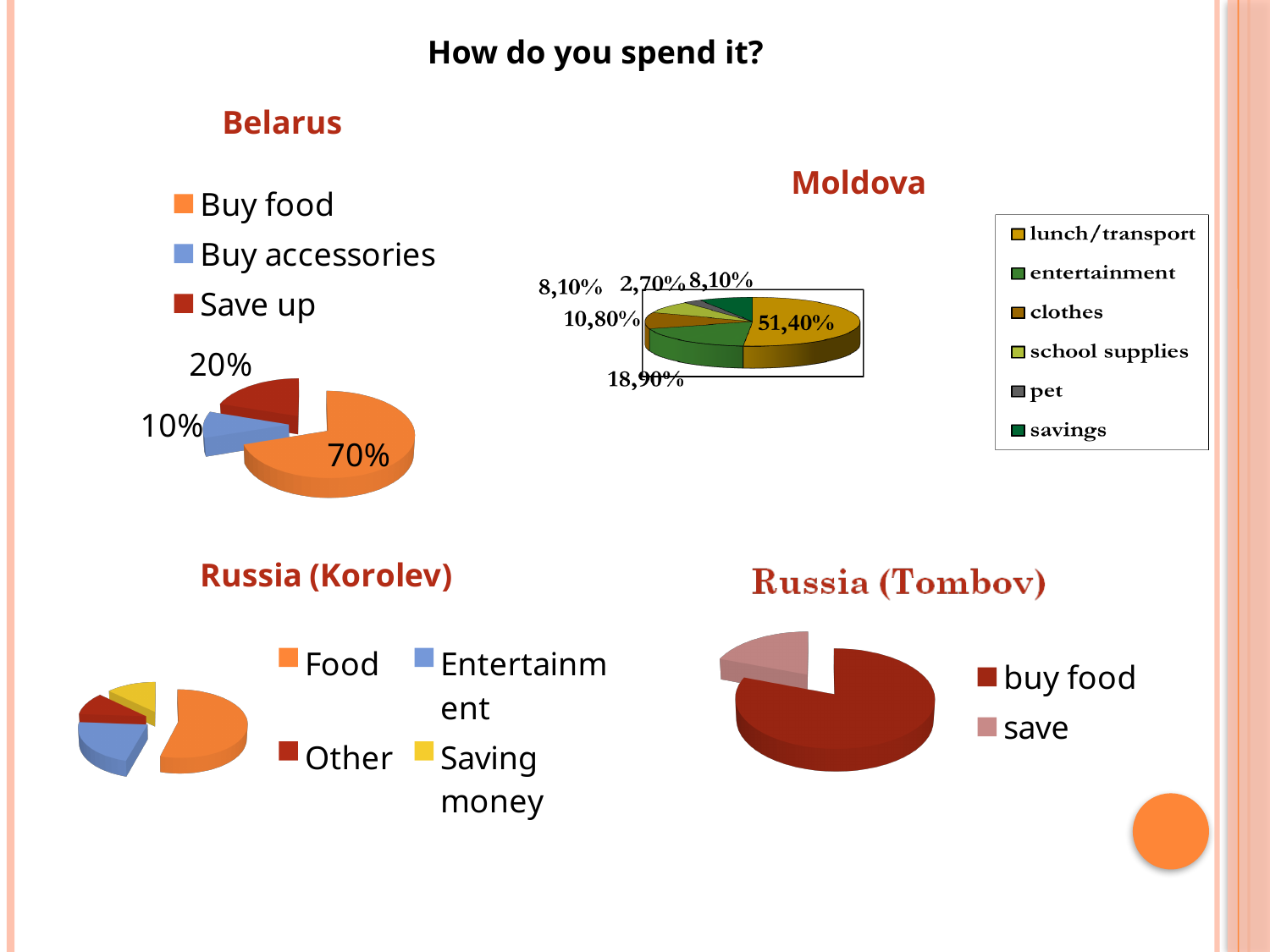
In the Belarus chart, how many categories does the legend list? 3 In the Moldova chart, how many categories does the legend list? 6 What kind of chart is used for Russia (Tombov)? Pie chart In the Moldova chart, what is the largest percentage shown on the pie? 51,40% In the Moldova chart, which category has the largest share? lunch/transport In the Belarus chart, what percentage is shown for Save up? 20% In the Belarus chart, what percentage is shown for Buy accessories? 10% In the Belarus chart, what percentage is shown for Buy food? 70% In the Belarus chart, what is the difference between the Buy food share and the Save up share? 50% In the Belarus chart, which category has the smallest share? Buy accessories In the Russia (Korolev) chart, which category has the largest share? Food In the Russia (Tombov) chart, which is larger, buy food or save? buy food